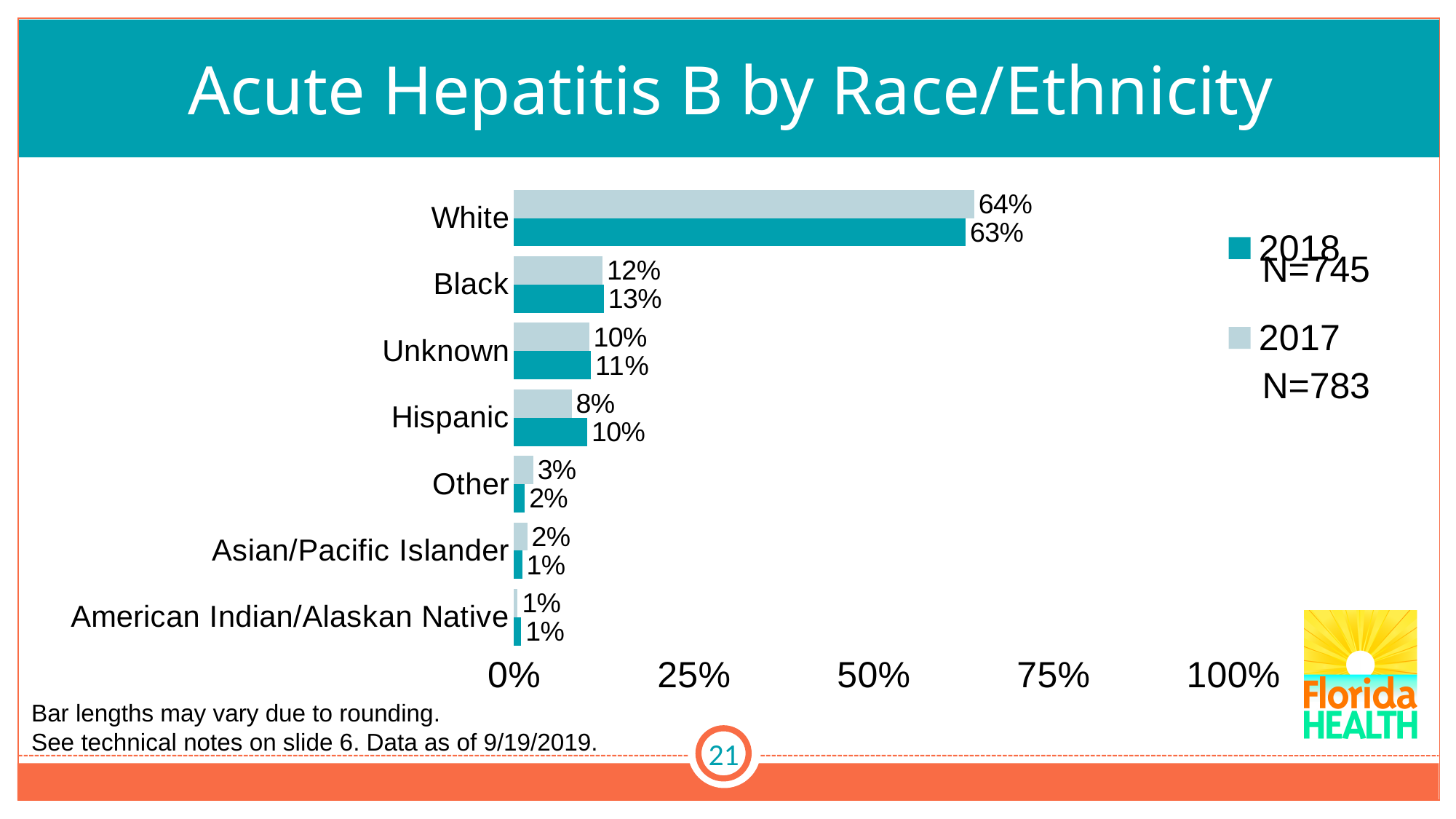
What is the 2018 value for Black? 13% What is the N for the 2017 series shown in the legend? N=783 Is the 2017 value for White greater or less than 50%? greater How many race/ethnicity categories are shown on the chart? 7 What kind of chart is shown on the slide? Bar chart What is the difference between the 2017 and 2018 values for Hispanic? 2% What is the 2018 value for White? 63% What is the 2017 value for Hispanic? 8% Which is larger for Unknown, the 2017 value or the 2018 value? 2018 Which race/ethnicity category has the lowest 2017 value? American Indian/Alaskan Native Which race/ethnicity category has the highest 2018 value? White How many series does the legend list? 2